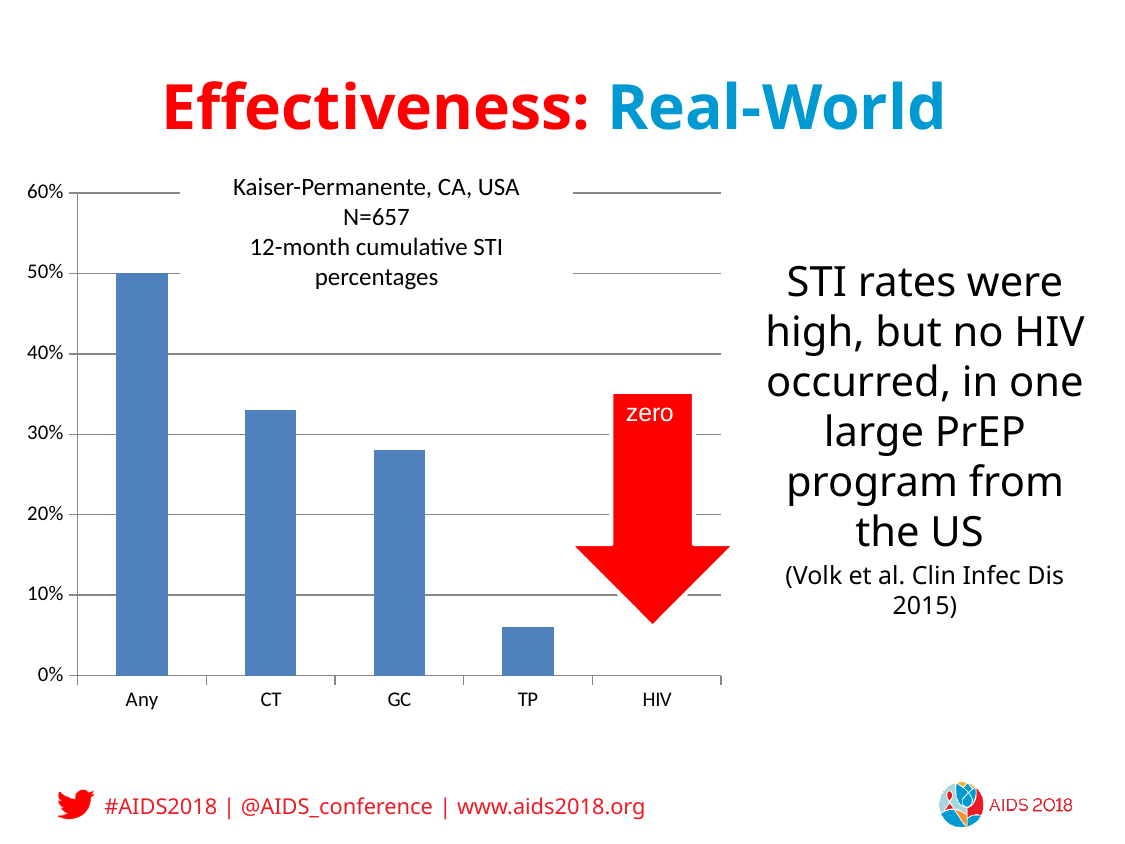
Is the value for CT greater or less than 30%? greater Which is larger, the value for CT or the value for GC? CT What is the value for Any in the chart? 50% Is the value for TP greater or less than 10%? less What sample size (N) is stated in the chart's title text? N=657 What value does the red arrow label give for HIV? zero Do the bar values rise or fall from left to right across the x axis? fall Is the value for GC greater or less than 30%? less Which category has the lowest value in the chart? HIV Which category has the highest value in the chart? Any How many categories are shown on the x axis of the chart? 5 What type of chart is shown on the slide? bar chart